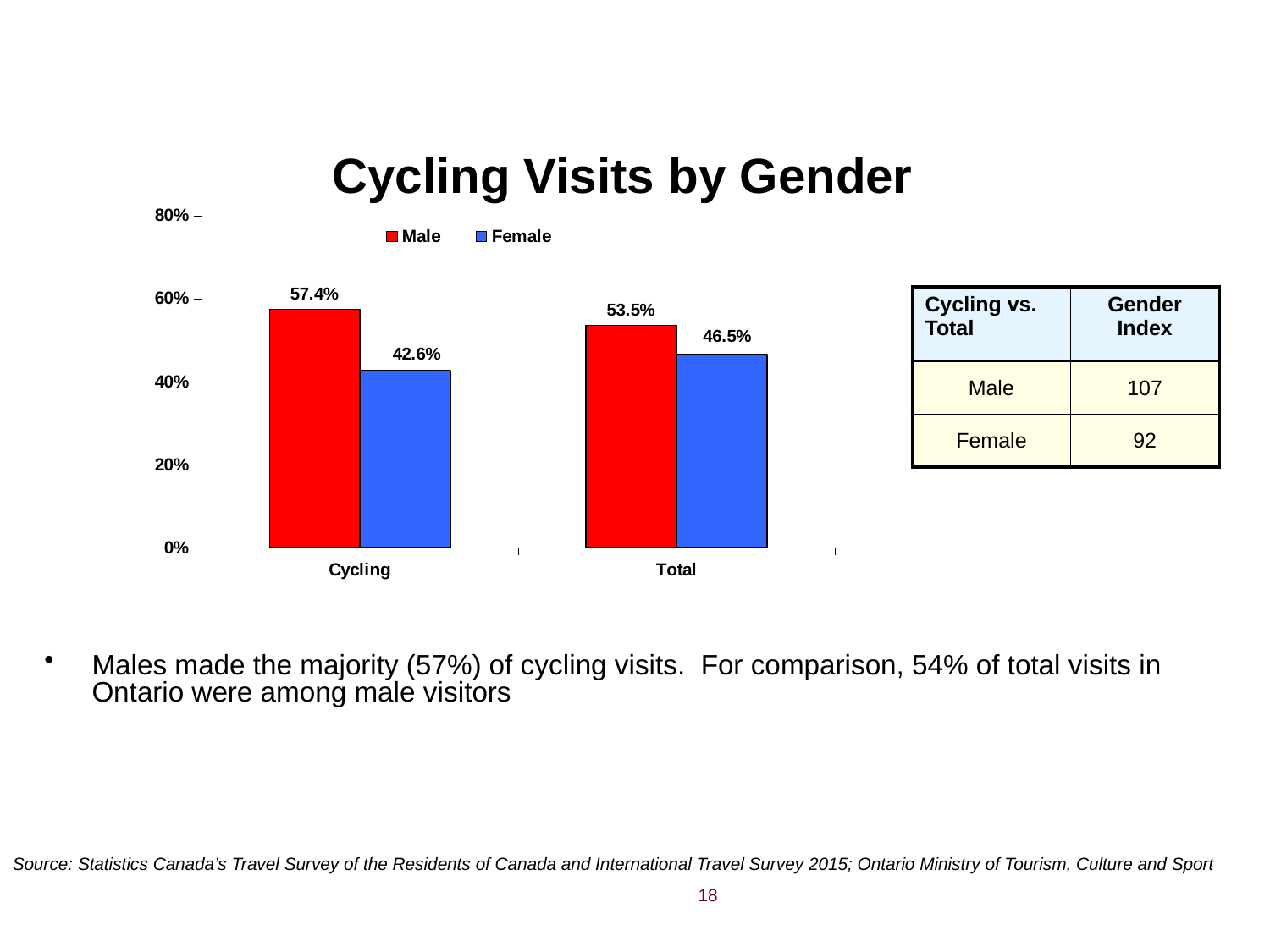
What is the Male value for Total? 53.5% What is the title of the chart? Cycling Visits by Gender Which series has the higher value for Cycling, Male or Female? Male What kind of chart is shown on the slide? Bar chart What is the Female value for Total? 46.5% What is the difference between the Male value for Cycling and the Male value for Total? 3.9% What is the Female value for Cycling? 42.6% What is the difference between the Male and Female values for Cycling? 14.8% How many series does the legend list? 2 Which bar in the chart is the lowest? Female, Cycling What is the Male value for Cycling? 57.4% Is the Female value for Total greater or less than 40%? greater